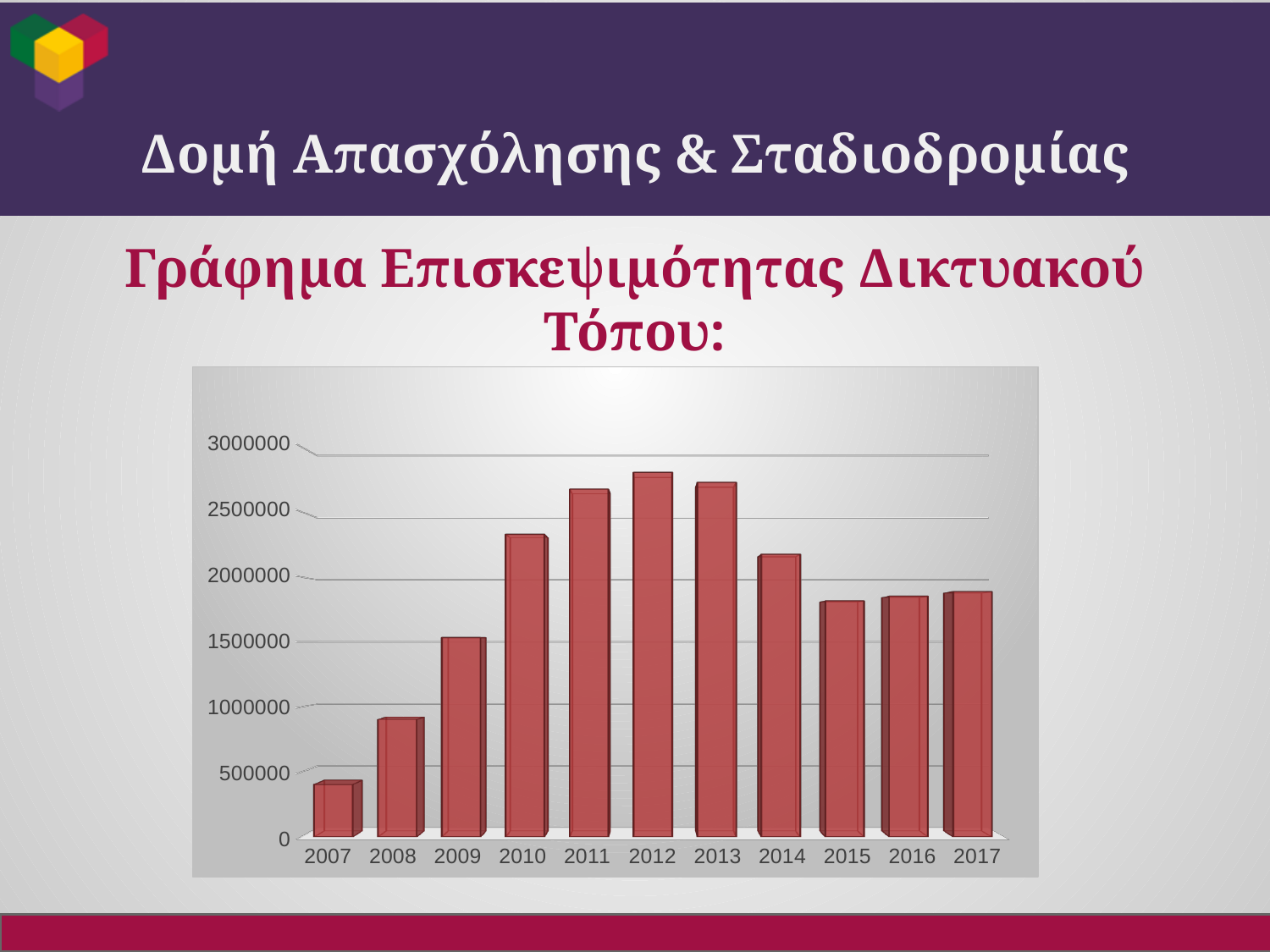
Is the value for 2015 greater or less than 2000000? less Is the value for 2007 greater or less than 500000? less Which year has the larger value, 2008 or 2009? 2009 How many years are shown on the x axis of the chart? 11 Is the value for 2014 greater or less than 2000000? greater Which year has the lowest value in the chart? 2007 Do the values rise or fall from 2007 to 2012? rise Which year has the highest value in the chart? 2012 What kind of chart is shown on the slide? Bar chart What is the title shown above the chart? Γράφημα Επισκεψιμότητας Δικτυακού Τόπου: